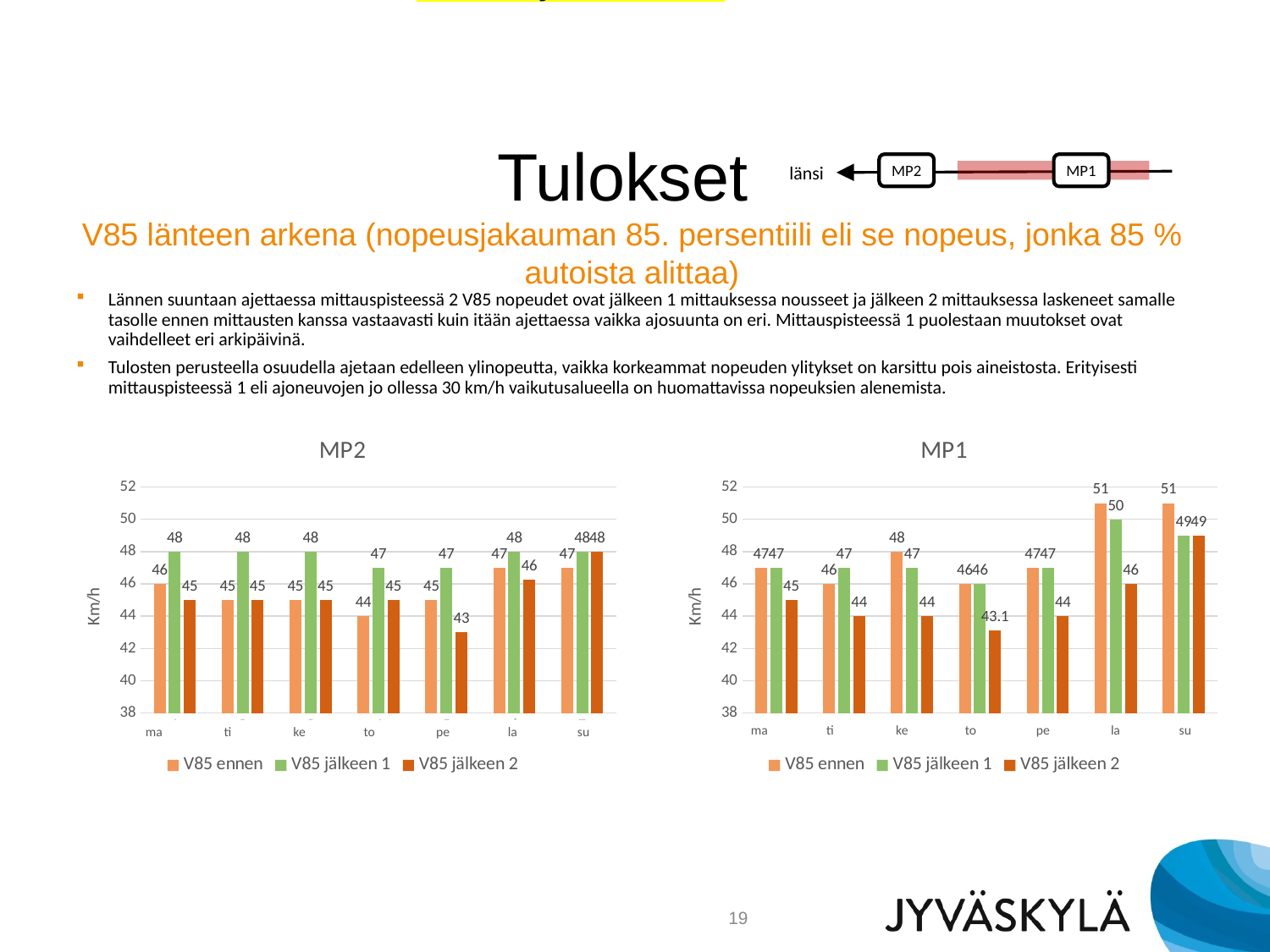
In the MP2 chart, what is the V85 jälkeen 2 value for pe? 43 What kind of chart is the MP1 chart? Bar chart What is the y-axis label of the MP2 chart? Km/h In the MP2 chart, what is the V85 ennen value for ma? 46 In the MP2 chart, which is larger for ma: V85 ennen or V85 jälkeen 1? V85 jälkeen 1 In the MP1 chart, what is the V85 jälkeen 2 value for to? 43.1 In the MP1 chart, what is the difference between the V85 ennen and V85 jälkeen 2 values for la? 5 In the MP1 chart, which day has the lowest V85 jälkeen 2 value? to In the MP1 chart, what is the V85 jälkeen 1 value for la? 50 In the MP2 chart, which day has the lowest V85 jälkeen 2 value? pe How many days are shown on the x axis of the MP1 chart? 7 How many series does the legend of the MP2 chart list? 3